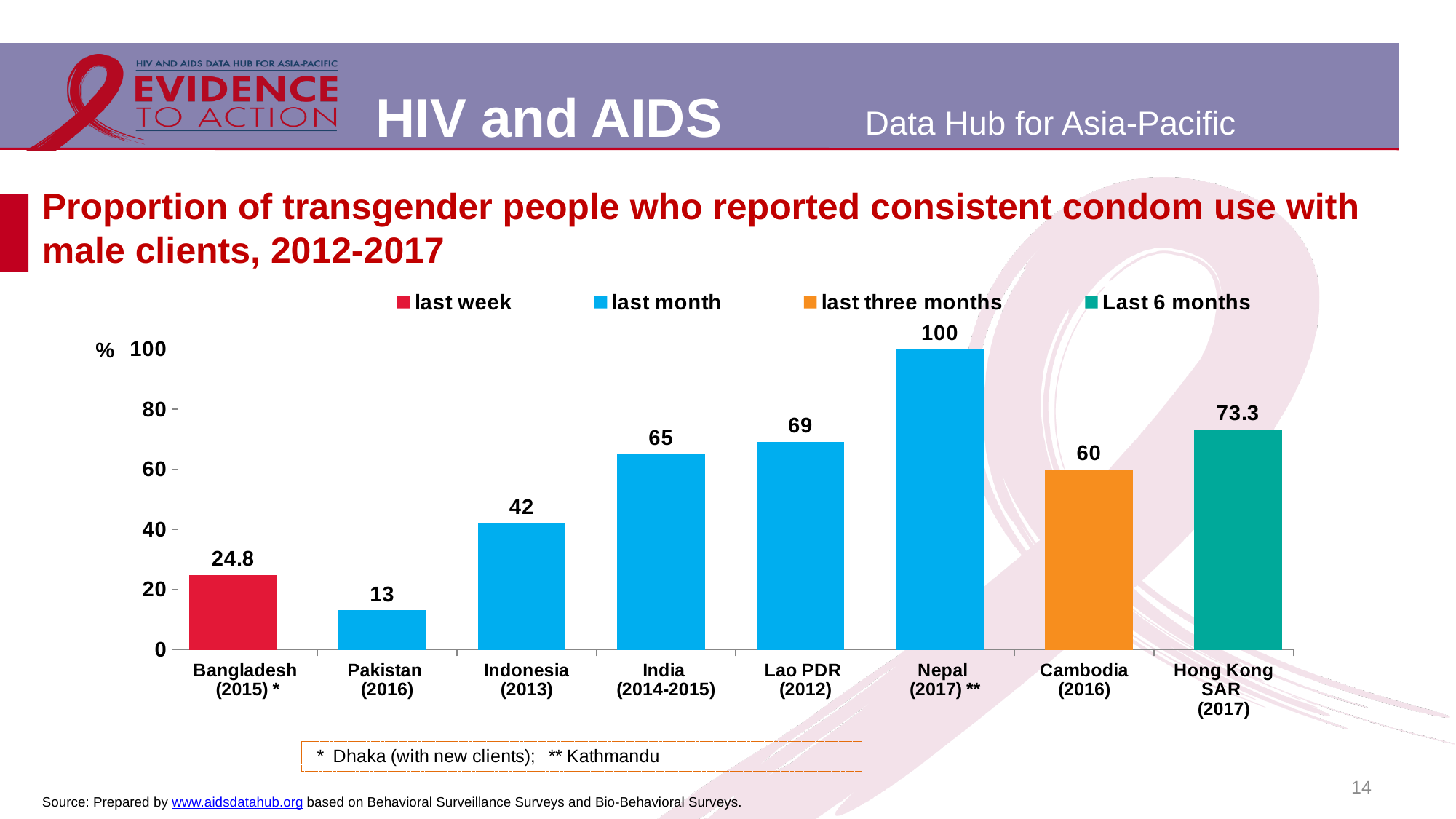
Which country has the lowest proportion? Pakistan (2016) How many series does the legend list? 4 How many countries are shown on the chart? 8 Which legend entry is shown in orange? last three months Is the value for Pakistan (2016) greater or less than 20? less Which is larger, the value for Cambodia (2016) or Indonesia (2013)? Cambodia (2016) What is the value for Nepal (2017)? 100 What kind of chart is shown on the slide? bar chart What is the difference between the values for Lao PDR (2012) and India (2014-2015)? 4 Which country has the highest proportion? Nepal (2017) What is the value for Bangladesh (2015)? 24.8 What is the value for Hong Kong SAR (2017)? 73.3